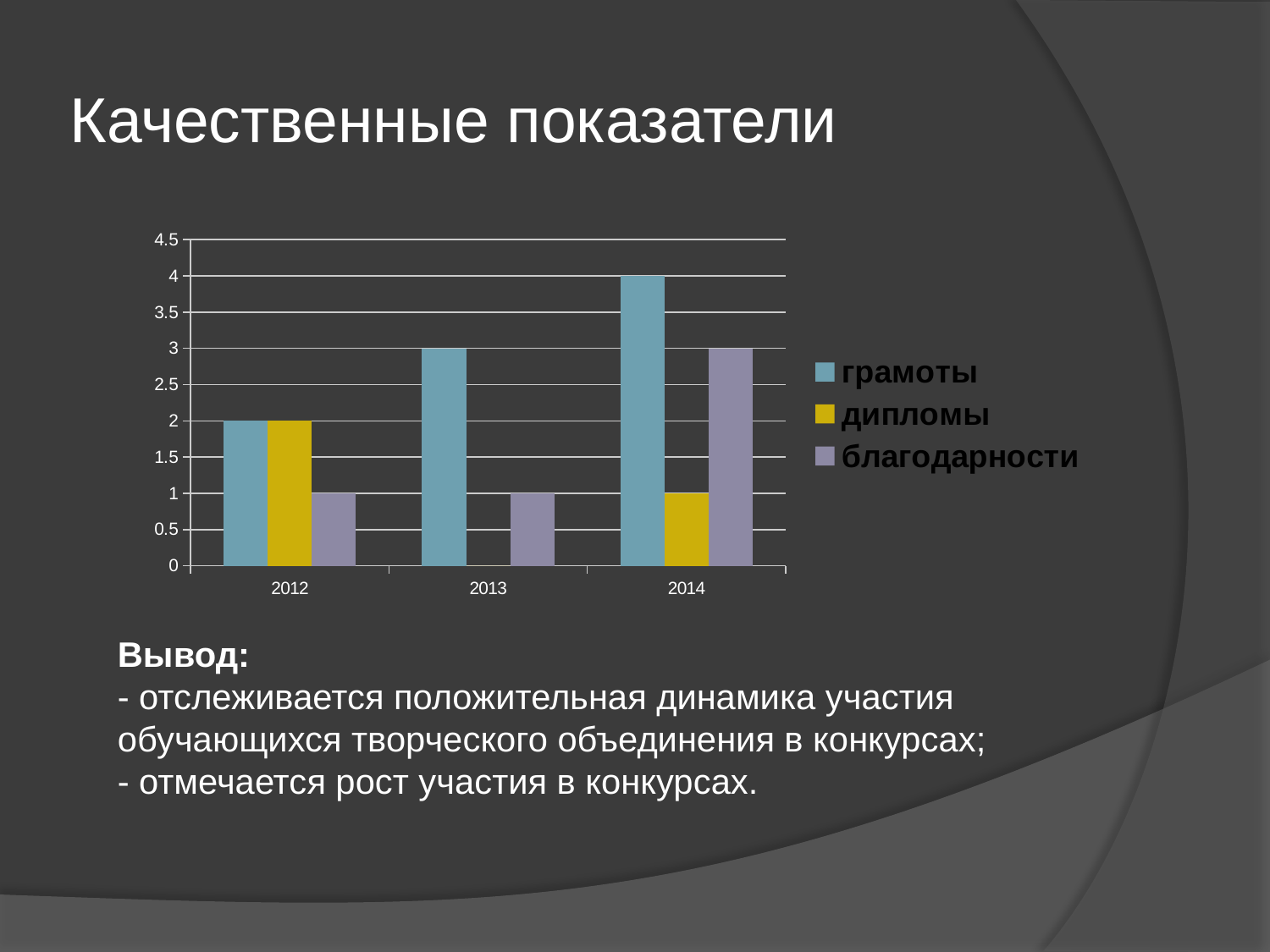
How many years are shown on the x axis of the chart? 3 What is the value for благодарности in 2012? 1 What kind of chart is shown on the slide? bar chart How many series does the chart legend list? 3 Which series is shown in yellow in the chart legend? дипломы Do the values for грамоты rise or fall from 2012 to 2014? rise Which is larger in 2014, the value for дипломы or the value for благодарности? благодарности What is the value for дипломы in 2012? 2 What is the value for грамоты in 2014? 4 What is the difference between the грамоты values for 2014 and 2012? 2 In which year is the value for благодарности lowest? 2012 and 2013 (both 1) In which year is the value for грамоты highest? 2014